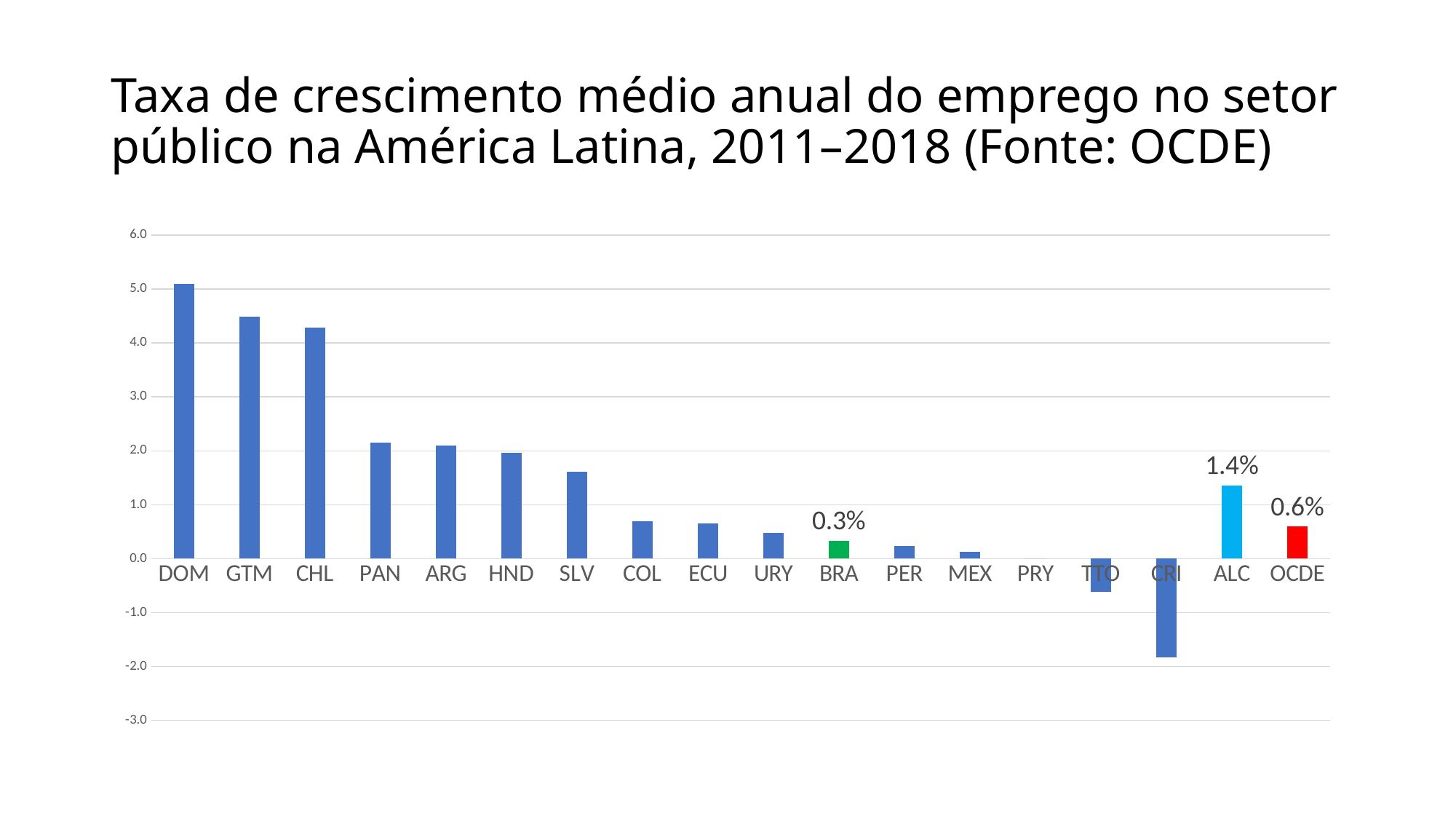
What is the value shown for BRA? 0.3% Is the value for GTM greater or less than 4.0? greater Is the value for CRI greater or less than -1.0? less What is the value shown for ALC? 1.4% What is the difference between the values for ALC and OCDE? 0.8% What colour is the bar for BRA? green What kind of chart is shown on the slide? bar chart How many categories are shown on the x axis? 18 Which category has the lowest value? CRI Which category has the highest value? DOM Which is larger, the value for DOM or the value for GTM? DOM What is the value shown for OCDE? 0.6%